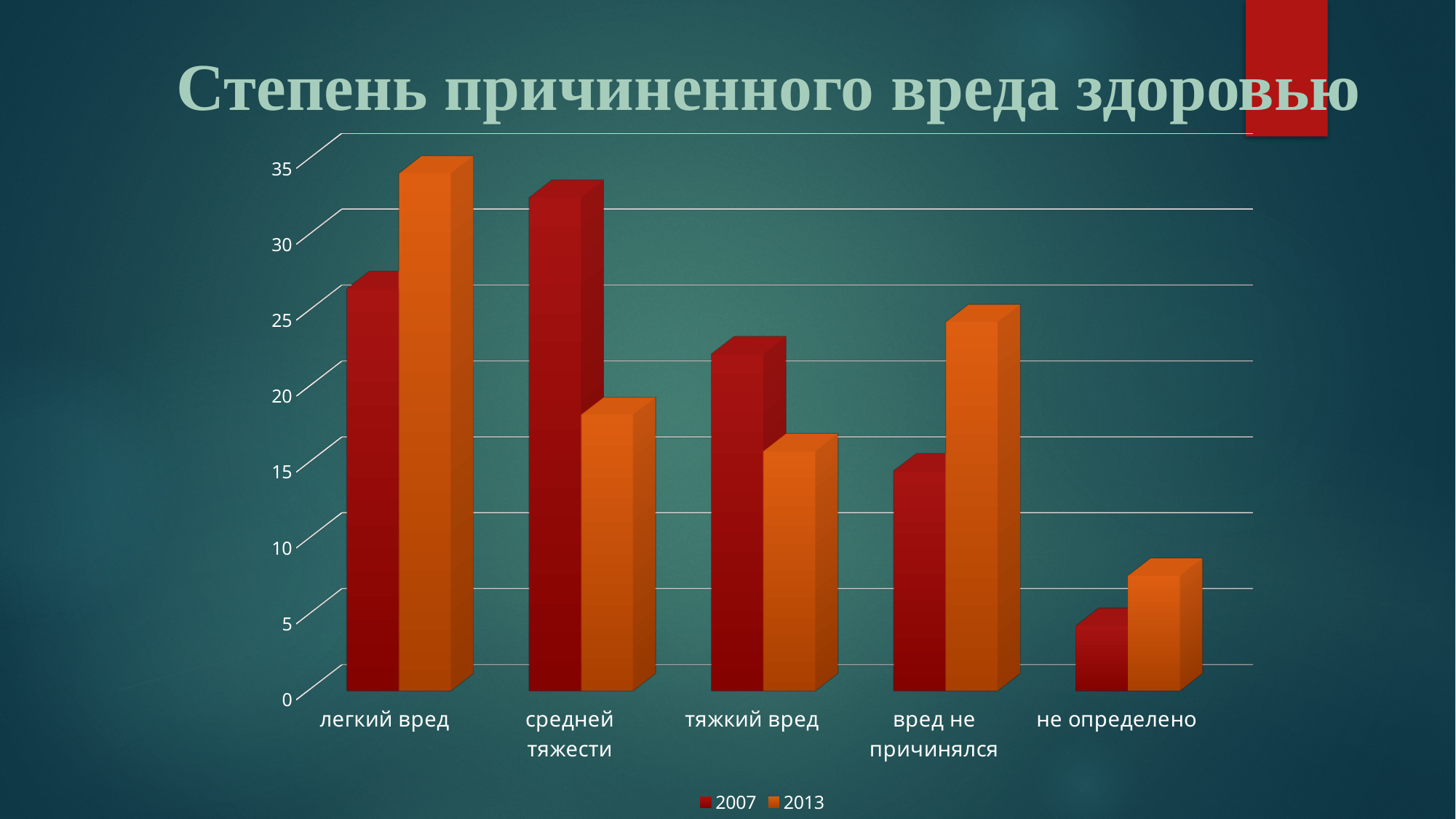
What is the title of the chart on the slide? Степень причиненного вреда здоровью For the category 'средней тяжести', which series has the larger value, 2007 or 2013? 2007 Which series does the legend list first? 2007 What kind of chart is shown on the slide? bar chart Which category has the lowest value for the 2007 series? не определено Is the 2007 value for 'не определено' greater or less than 10? less How many categories are shown on the x axis of the chart? 5 Which category has the highest value for the 2013 series? легкий вред How many series does the legend list? 2 Which category has the highest value for the 2007 series? средней тяжести For the category 'вред не причинялся', which series has the larger value, 2007 or 2013? 2013 Is the 2013 value for 'легкий вред' greater or less than 30? greater